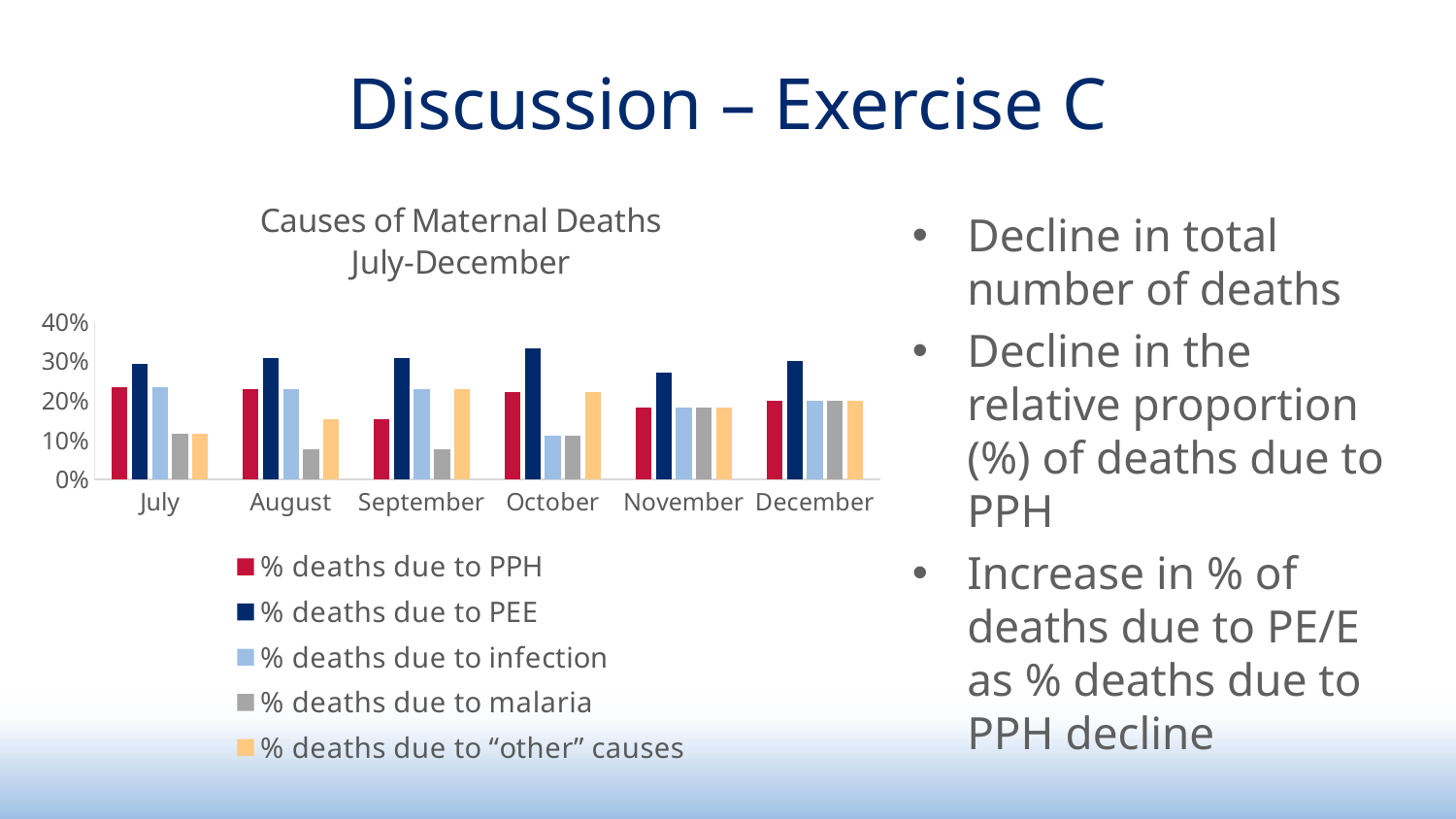
Is the value for % deaths due to PEE in October greater or less than 30%? greater What kind of chart is shown on the slide? Bar chart How many series does the legend list? 5 What is the title of the chart? Causes of Maternal Deaths July-December Which cause has the lowest percentage of deaths in August? % deaths due to malaria In October, which is larger: % deaths due to infection or % deaths due to "other" causes? % deaths due to "other" causes Is the value for % deaths due to PPH in September greater or less than 20%? less Which cause has the highest percentage of deaths in October? % deaths due to PEE Is the value for % deaths due to PEE in November greater or less than 20%? greater In September, which is larger: % deaths due to PPH or % deaths due to PEE? % deaths due to PEE How many months are shown on the x axis? 6